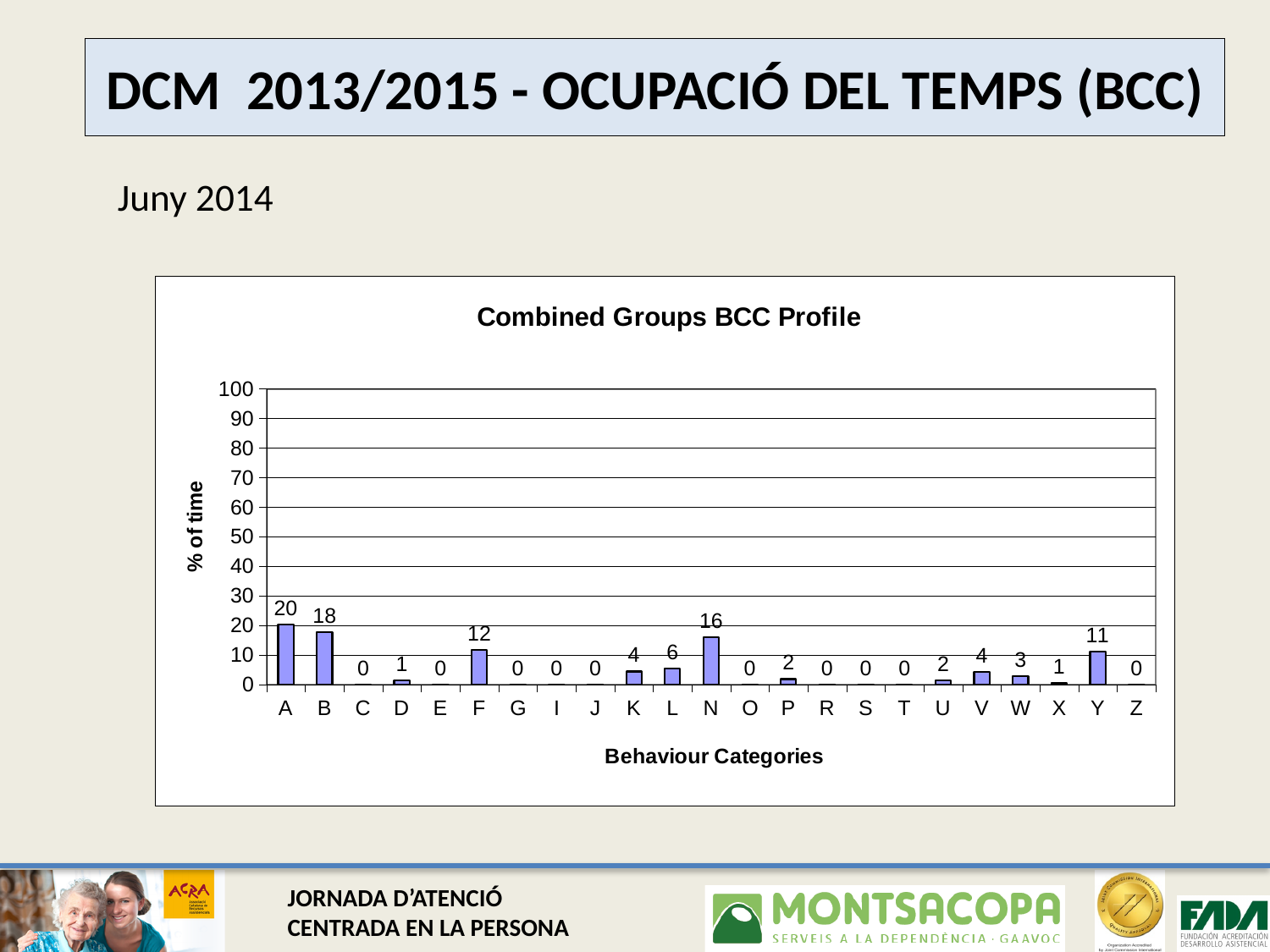
What is the difference between the values for categories F and Y? 1 What is the value for behaviour category Y? 11 What is the value for behaviour category A? 20 What is the value for behaviour category L? 6 Which is larger, the value for category K or the value for category W? K Which behaviour category has the highest % of time? A What is the title of the chart? Combined Groups BCC Profile What is the difference between the values for categories A and B? 2 What type of chart is shown on the slide? bar chart What is the label of the y axis? % of time What is the value for behaviour category N? 16 How many behaviour categories are shown on the x axis? 23